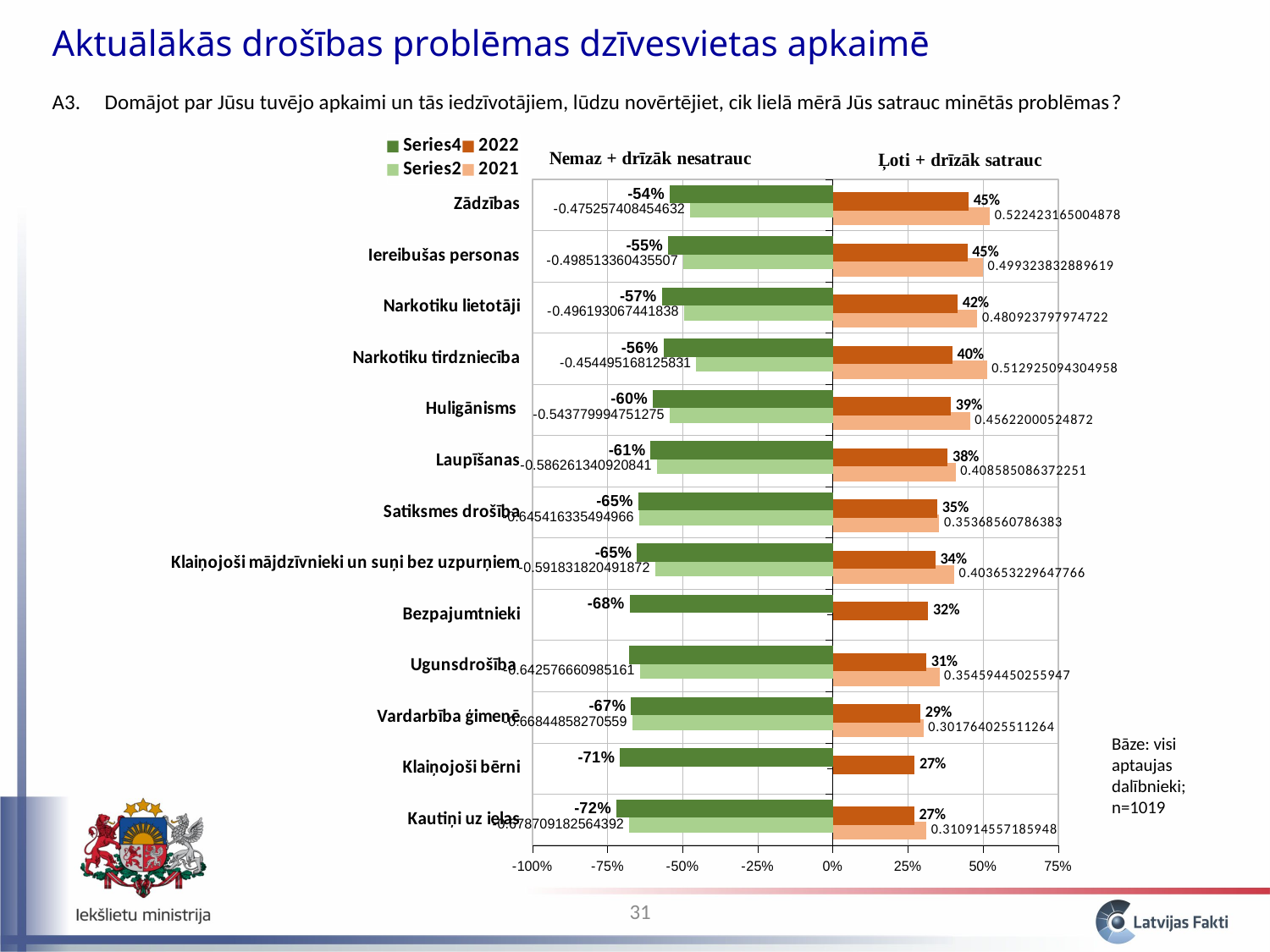
How many problem categories are listed on the chart? 13 What is the 2022 'Ļoti + drīzāk satrauc' value for Huligānisms? 39% How many entries does the chart legend list? 4 What is the 2022 'Nemaz + drīzāk nesatrauc' value for Kautiņi uz ielas? -72% Which is larger in 2022 'Ļoti + drīzāk satrauc': Zādzības or Bezpajumtnieki? Zādzības Is the 2022 'Ļoti + drīzāk satrauc' value for Bezpajumtnieki greater or less than 25%? greater What is the 2022 'Ļoti + drīzāk satrauc' value for Vardarbība ģimenē? 29% What type of chart is shown on the slide? Bar chart What is the 2022 'Nemaz + drīzāk nesatrauc' value for Bezpajumtnieki? -68% What is the 2022 'Ļoti + drīzāk satrauc' value for Zādzības? 45% What is the difference between the 2022 'Ļoti + drīzāk satrauc' values for Narkotiku lietotāji and Narkotiku tirdzniecība? 2 percentage points What is the difference between the 2022 'Ļoti + drīzāk satrauc' values for Zādzības and Kautiņi uz ielas? 18 percentage points